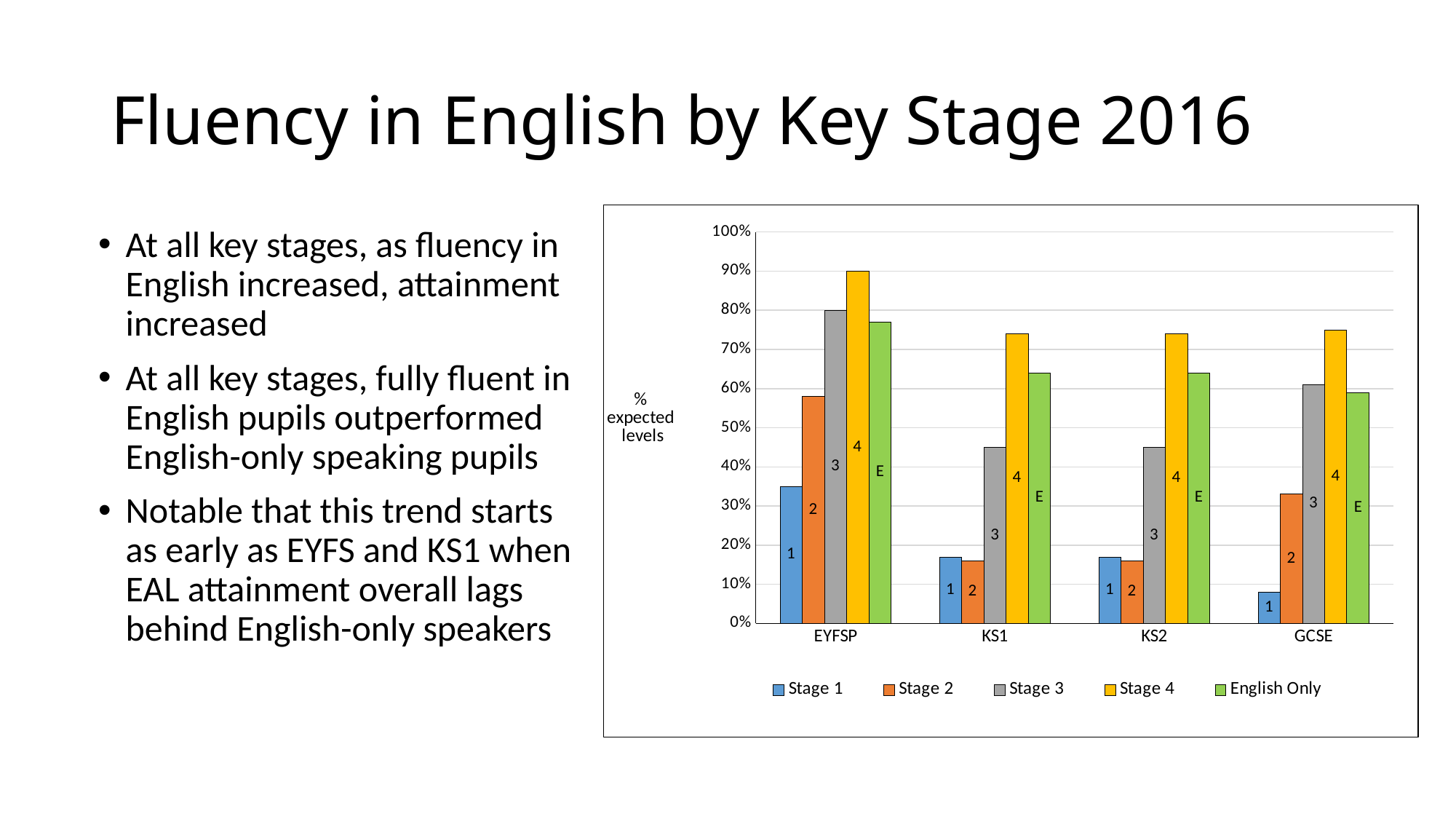
Is the value for Stage 2 at GCSE greater or less than 40%? less Which key stage has the highest Stage 4 bar? EYFSP How many series does the legend list? 5 Is the value for English Only at GCSE greater or less than 50%? greater What kind of chart is shown on the slide? bar chart How many key stage categories are shown on the x axis? 4 At EYFSP, which is larger: the Stage 4 bar or the English Only bar? Stage 4 At KS2, which is larger: the Stage 3 bar or the English Only bar? English Only What is the label on the y axis of the chart? % expected levels Is the value for Stage 1 at EYFSP greater or less than 30%? greater Do the Stage 1 values rise or fall from EYFSP to GCSE? fall Which key stage has the lowest Stage 1 bar? GCSE